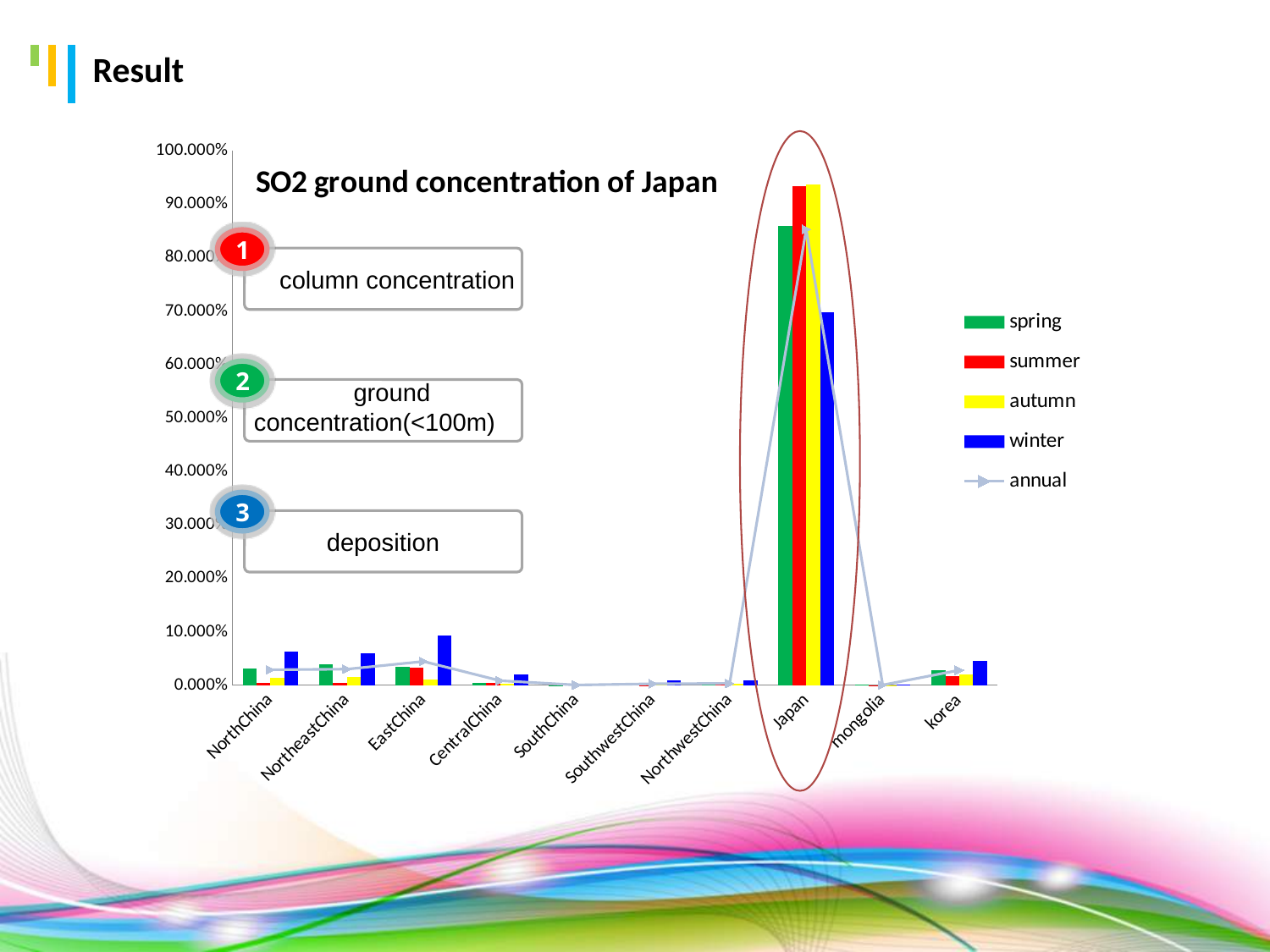
How many categories are shown on the x axis of the chart? 10 Is the spring value for Japan greater or less than 80.000%? greater What kind of chart is shown on the slide? combination bar and line chart Which is larger: the spring value for Japan or the spring value for korea? Japan For Japan, which is larger: the summer value or the winter value? summer Is the summer value for Japan greater or less than 90.000%? greater Which series is shown as a line with arrow markers in the legend? annual What is the title of the chart? SO2 ground concentration of Japan How many series does the chart legend list? 5 Is the winter value for EastChina greater or less than 20.000%? less Which category has the highest values in the chart? Japan